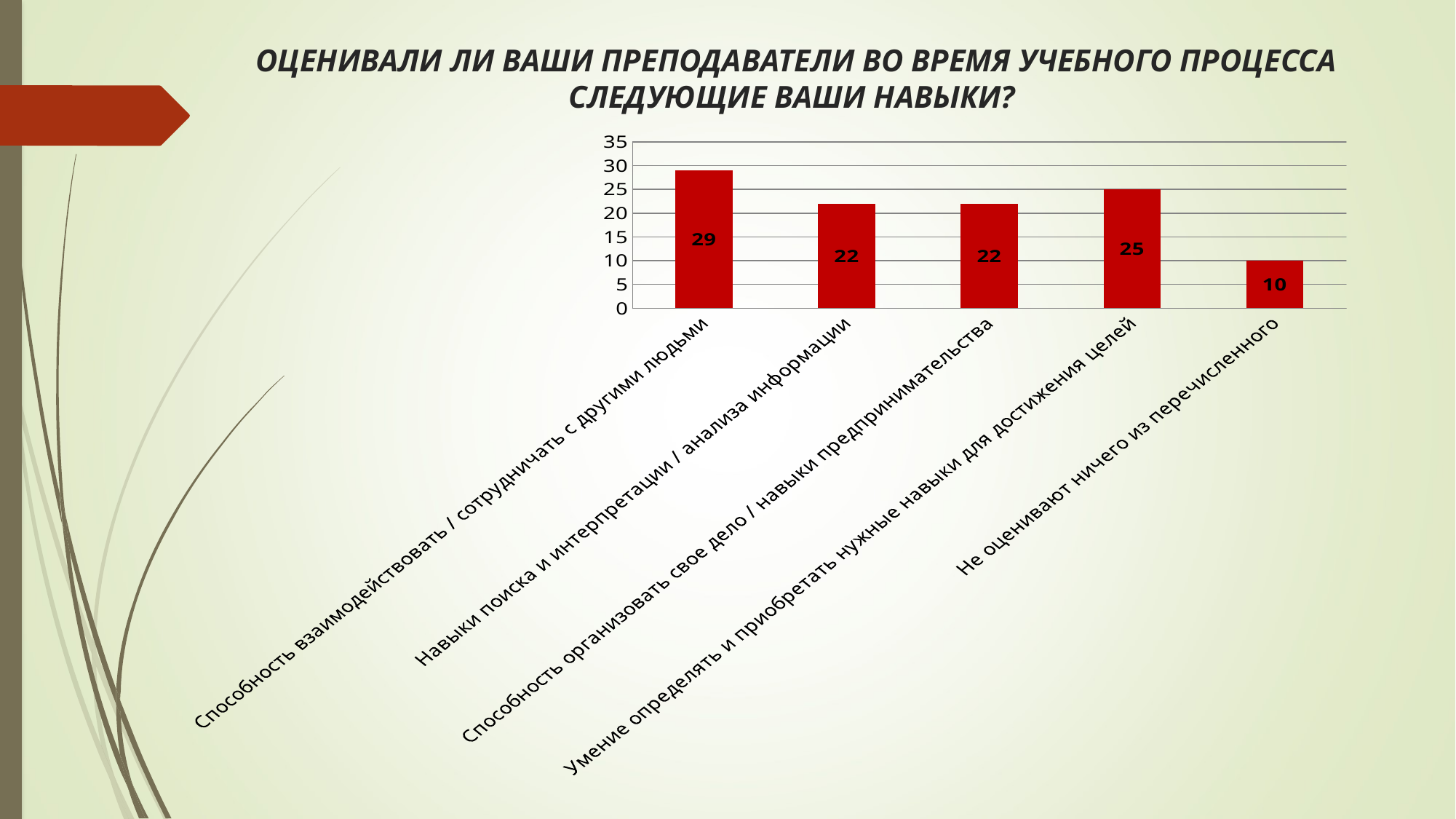
What is the value for "Способность взаимодействовать / сотрудничать с другими людьми"? 29 What is the difference between the values for "Способность взаимодействовать / сотрудничать с другими людьми" and "Не оценивают ничего из перечисленного"? 19 What is the value for "Не оценивают ничего из перечисленного"? 10 What is the value for "Умение определять и приобретать нужные навыки для достижения целей"? 25 What kind of chart is shown on the slide? bar chart How many categories are shown in the chart? 5 Which category has the lowest value? Не оценивают ничего из перечисленного Which is larger: the value for "Умение определять и приобретать нужные навыки для достижения целей" or for "Способность организовать свое дело / навыки предпринимательства"? Умение определять и приобретать нужные навыки для достижения целей What is the value for "Навыки поиска и интерпретации / анализа информации"? 22 What colour are the bars in the chart? red Is the value for "Способность организовать свое дело / навыки предпринимательства" greater or less than 20? greater Which category has the highest value? Способность взаимодействовать / сотрудничать с другими людьми